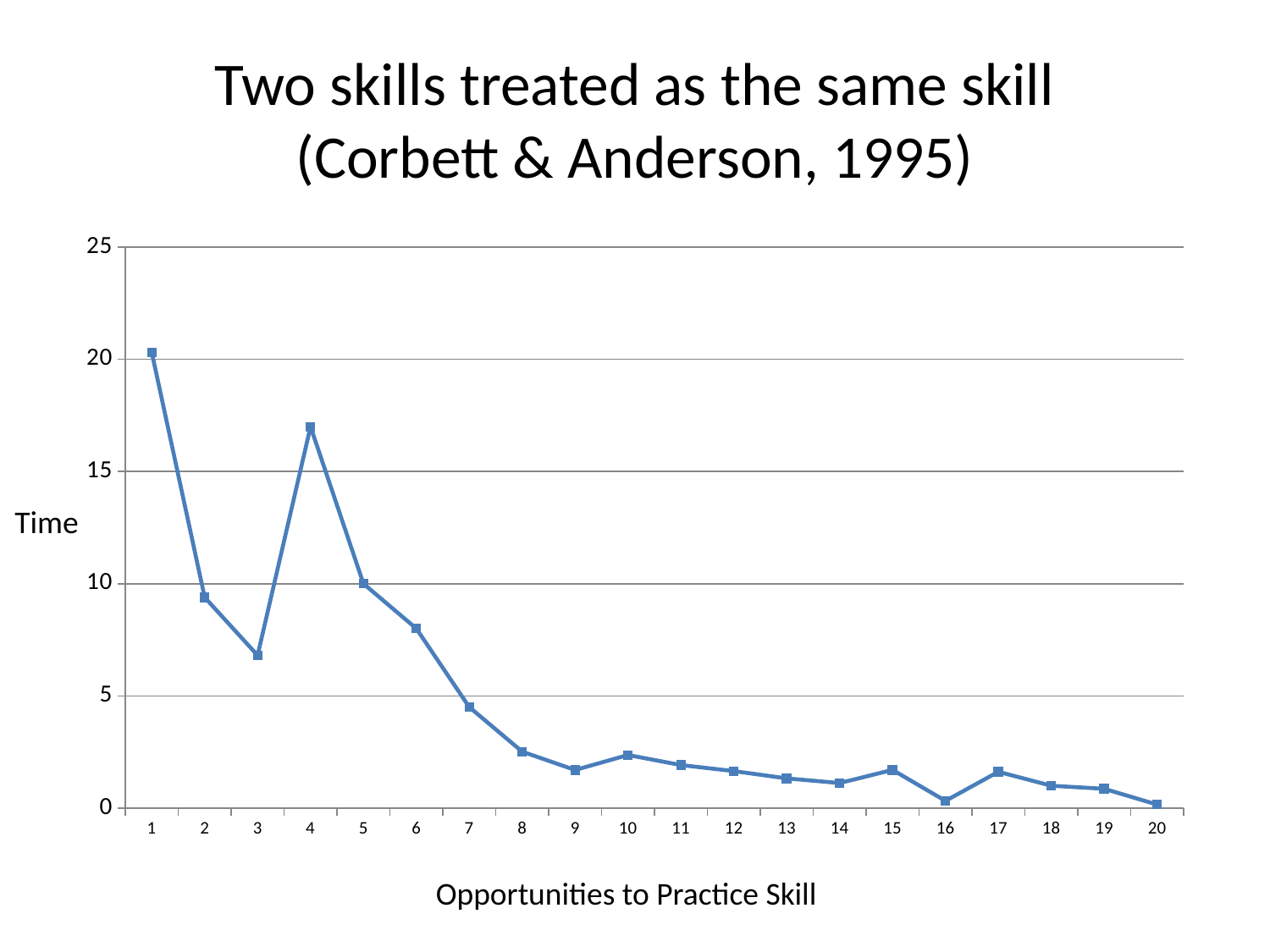
Is the time at opportunity 3 greater or less than 5? greater At which opportunity to practice skill is the time highest? 1 What kind of chart is shown on the slide? line chart What is the label on the y axis of the chart? Time Which has the larger time, opportunity 4 or opportunity 5? opportunity 4 What is the label on the x axis of the chart? Opportunities to Practice Skill Is the time at opportunity 7 greater or less than 5? less How many opportunities to practice skill are plotted along the x axis? 20 Overall, does the time rise or fall as the number of opportunities to practice skill increases? fall Is the time at opportunity 4 greater or less than 15? greater